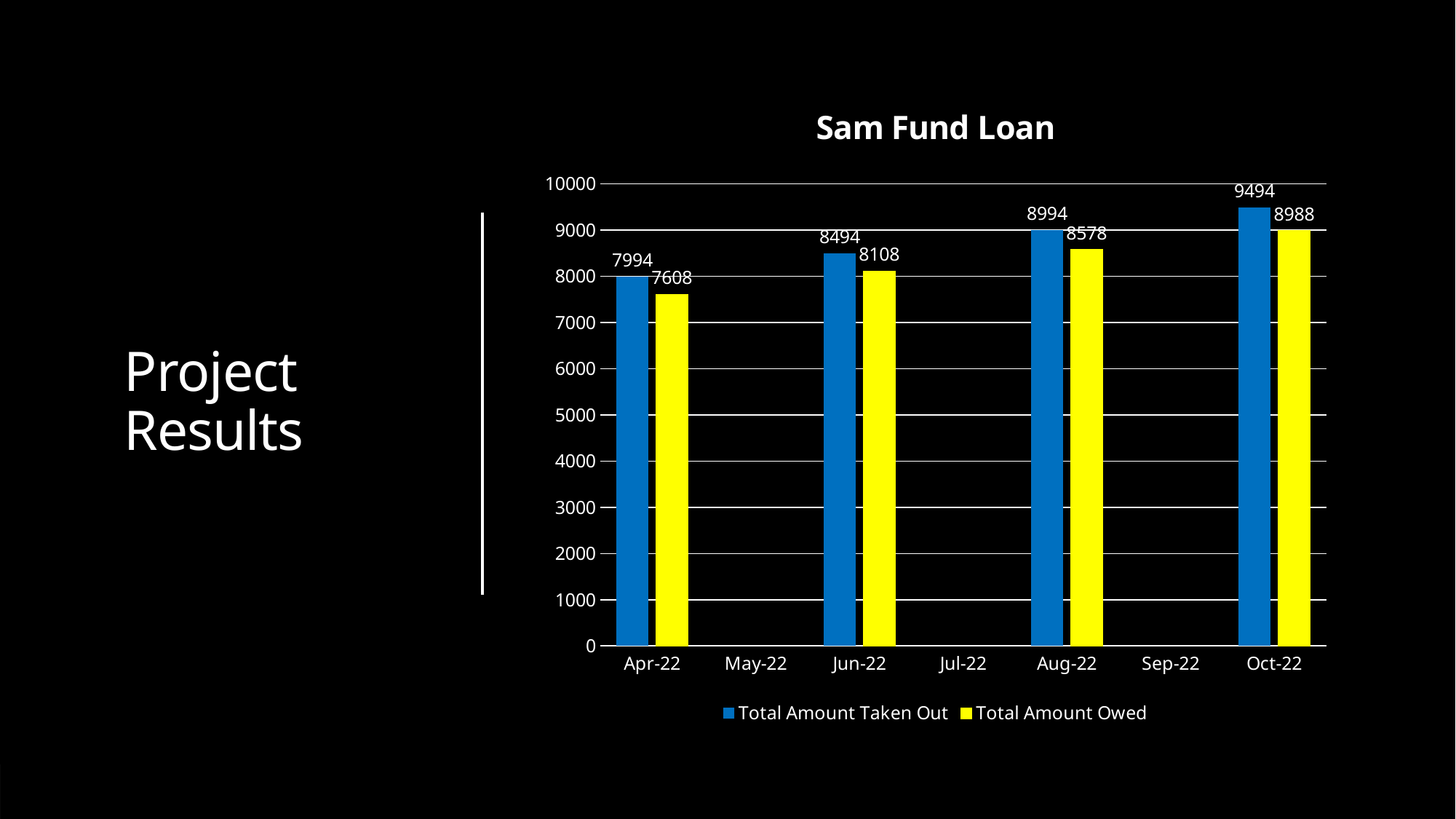
What is the Total Amount Owed for Aug-22? 8578 What is the title of the chart? Sam Fund Loan Does the Total Amount Taken Out rise or fall from Apr-22 to Oct-22? Rise What is the Total Amount Taken Out for Apr-22? 7994 What is the Total Amount Taken Out for Oct-22? 9494 What is the difference between Total Amount Taken Out and Total Amount Owed in Oct-22? 506 How many series does the legend list? 2 What kind of chart is shown on the slide? Bar chart Which is larger in Jun-22: Total Amount Taken Out or Total Amount Owed? Total Amount Taken Out What is the Total Amount Owed for Jun-22? 8108 Which month has the lowest Total Amount Taken Out? Apr-22 Which month has the highest Total Amount Owed? Oct-22